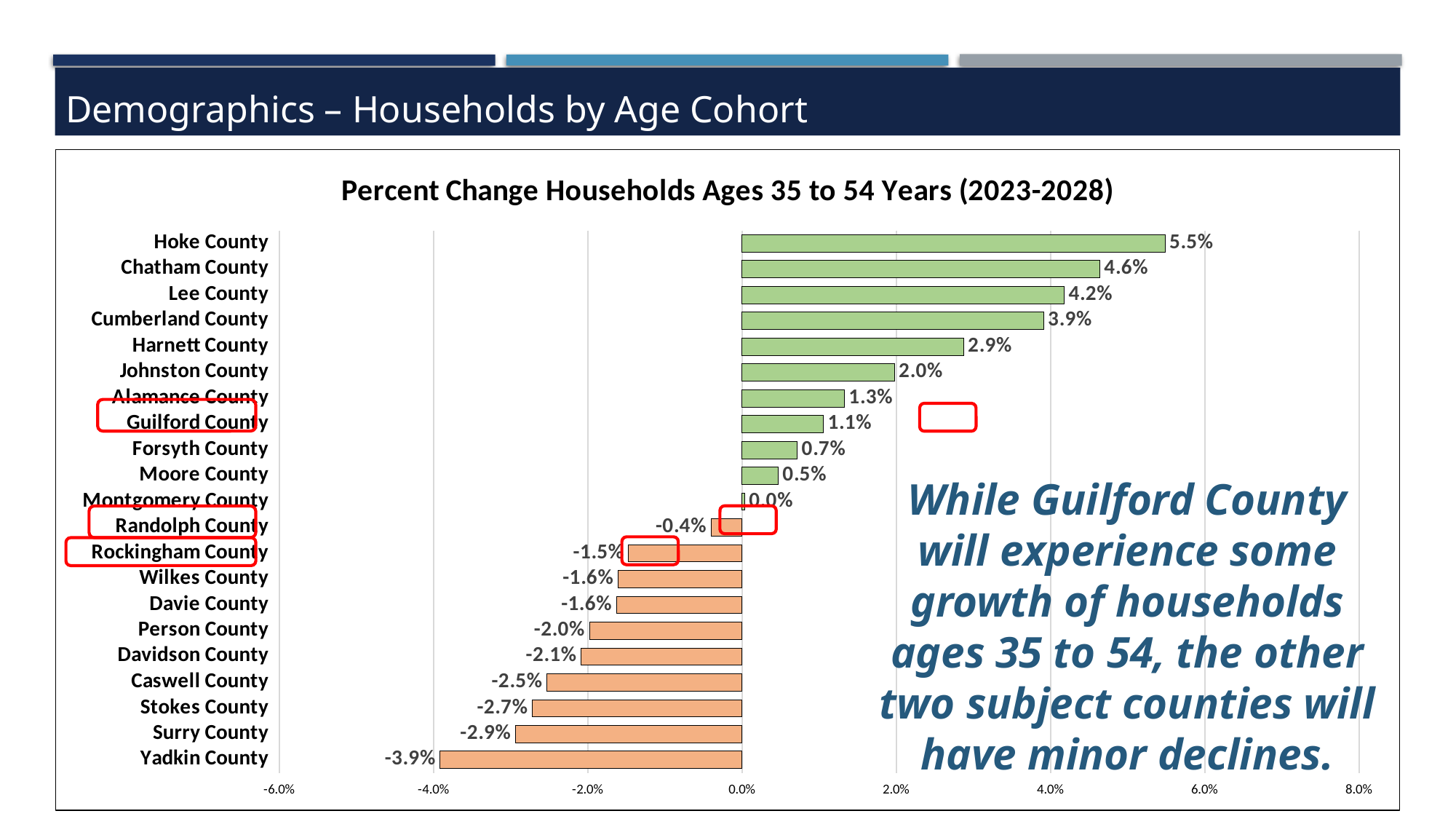
What is the percent change for Montgomery County? 0.0% What is the percent change for Rockingham County? -1.5% What is the percent change for Hoke County? 5.5% Which county has the lowest percent change? Yadkin County What is the difference between the percent change for Hoke County and Chatham County? 0.9% Which county has the highest percent change? Hoke County What is the title of the chart? Percent Change Households Ages 35 to 54 Years (2023-2028) Which has a larger percent change, Cumberland County or Harnett County? Cumberland County How many counties are shown in the chart? 21 What is the percent change for Guilford County? 1.1% What is the percent change for Randolph County? -0.4% What kind of chart is shown on the slide? Bar chart